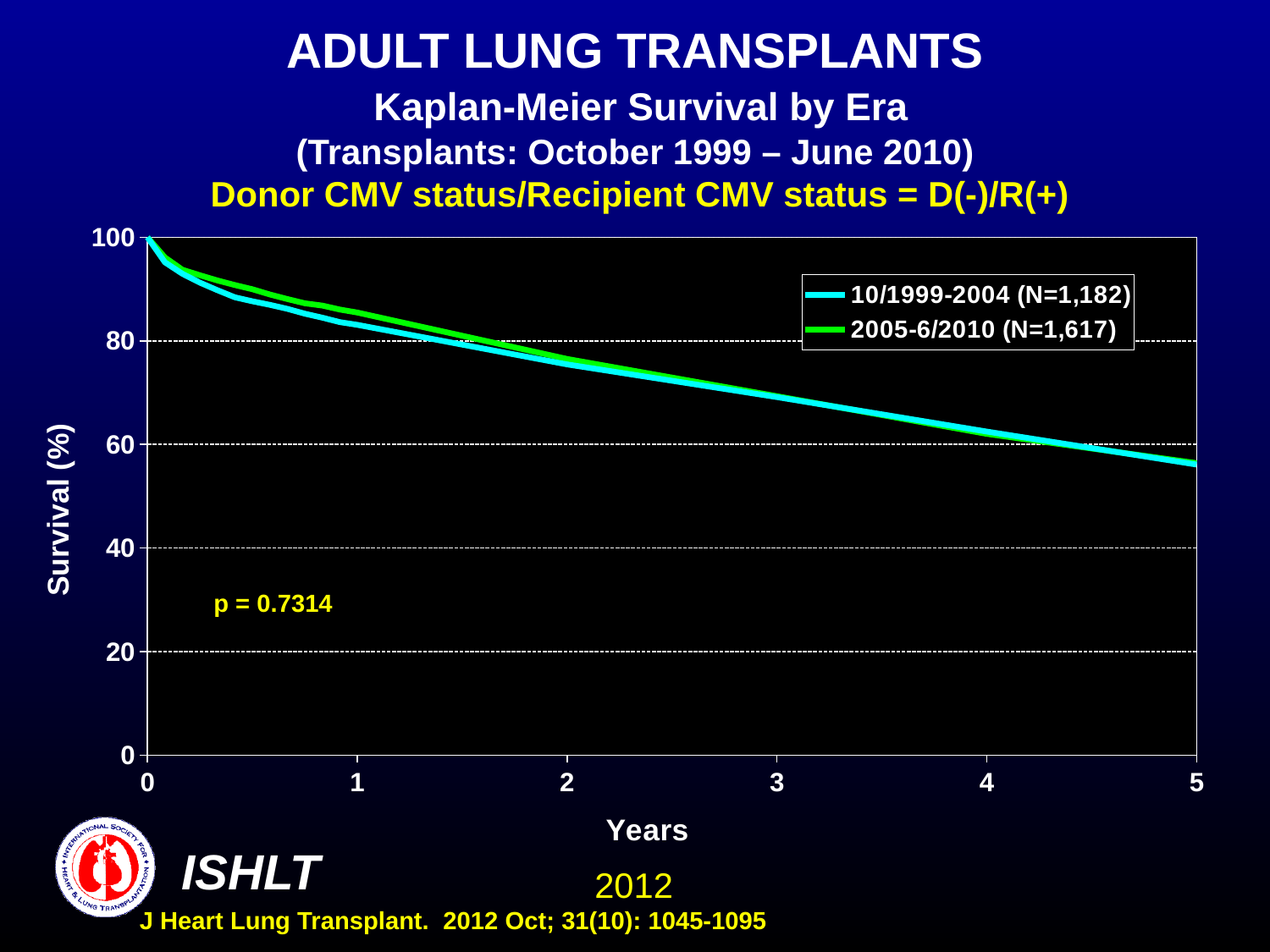
Is the survival value for the 10/1999-2004 series at 3 years greater or less than 80? less Is the survival value for the 2005-6/2010 series at 5 years greater or less than 60? less Is the survival value for the 10/1999-2004 series at 1 year greater or less than 80? greater What is the p-value printed on the chart? p = 0.7314 What is the label of the y axis? Survival (%) How many series does the legend list? 2 What is the survival value for both series at 0 years? 100 What kind of chart is shown on the slide? line chart Do the survival curves rise or fall as years increase? fall What is the sample size (N) for the 2005-6/2010 series shown in the legend? N=1,617